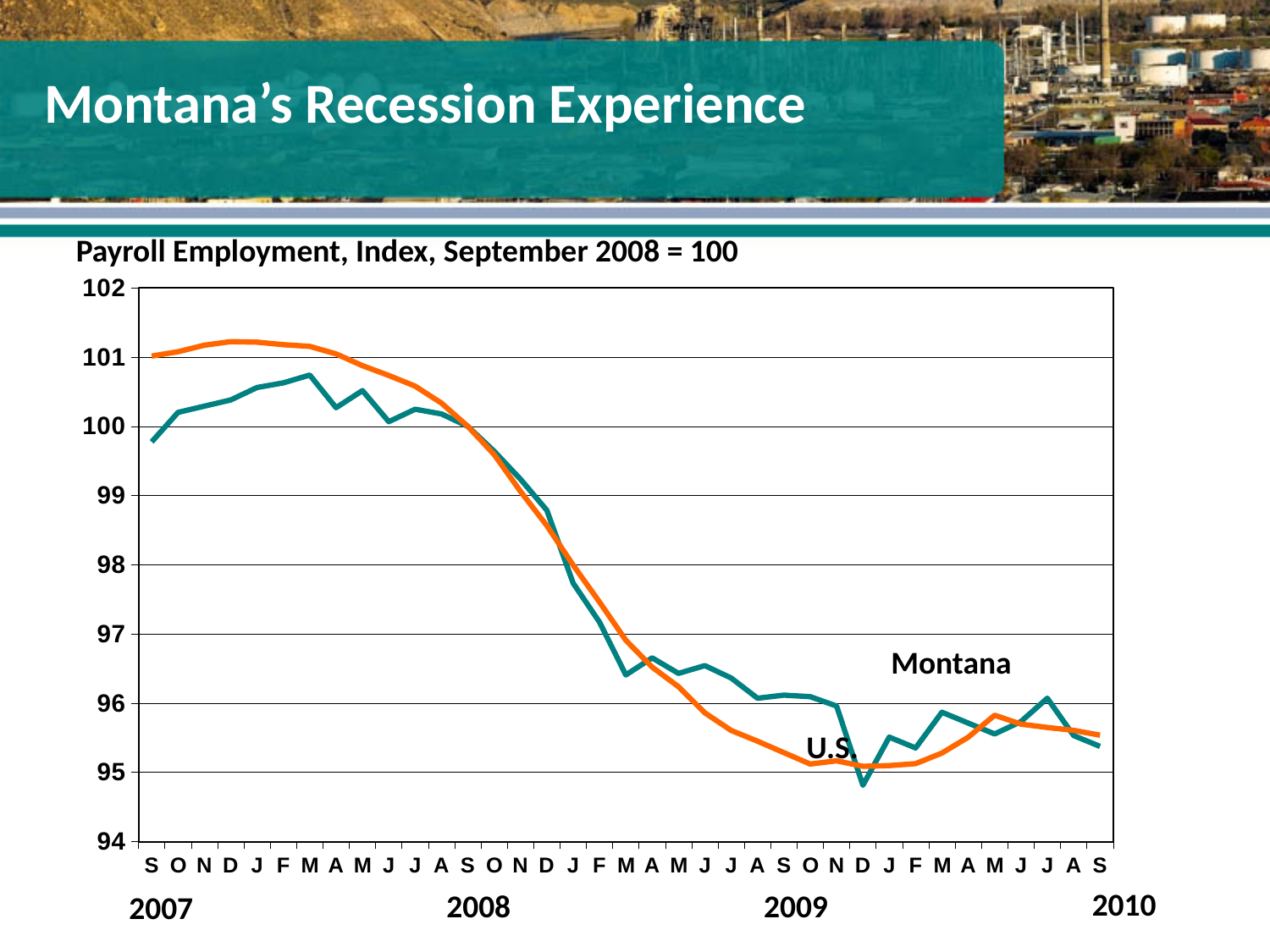
What is the title of the chart? Payroll Employment, Index, September 2008 = 100 Overall, do the index values rise or fall from September 2007 to September 2010? fall Which two series are labelled on the chart? Montana and U.S. In which month does the Montana series reach its lowest value? December 2009 Is the highest U.S. value greater or less than 101? greater How many series are plotted on the chart? 2 Which series has the higher value in September 2007, Montana or U.S.? U.S. What kind of chart is shown on the slide? line chart Is the Montana value in September 2007 greater or less than 100? less Which series has the higher value in September 2009, Montana or U.S.? Montana Is the Montana value in December 2009 greater or less than 95? less What is the index value for September 2008? 100